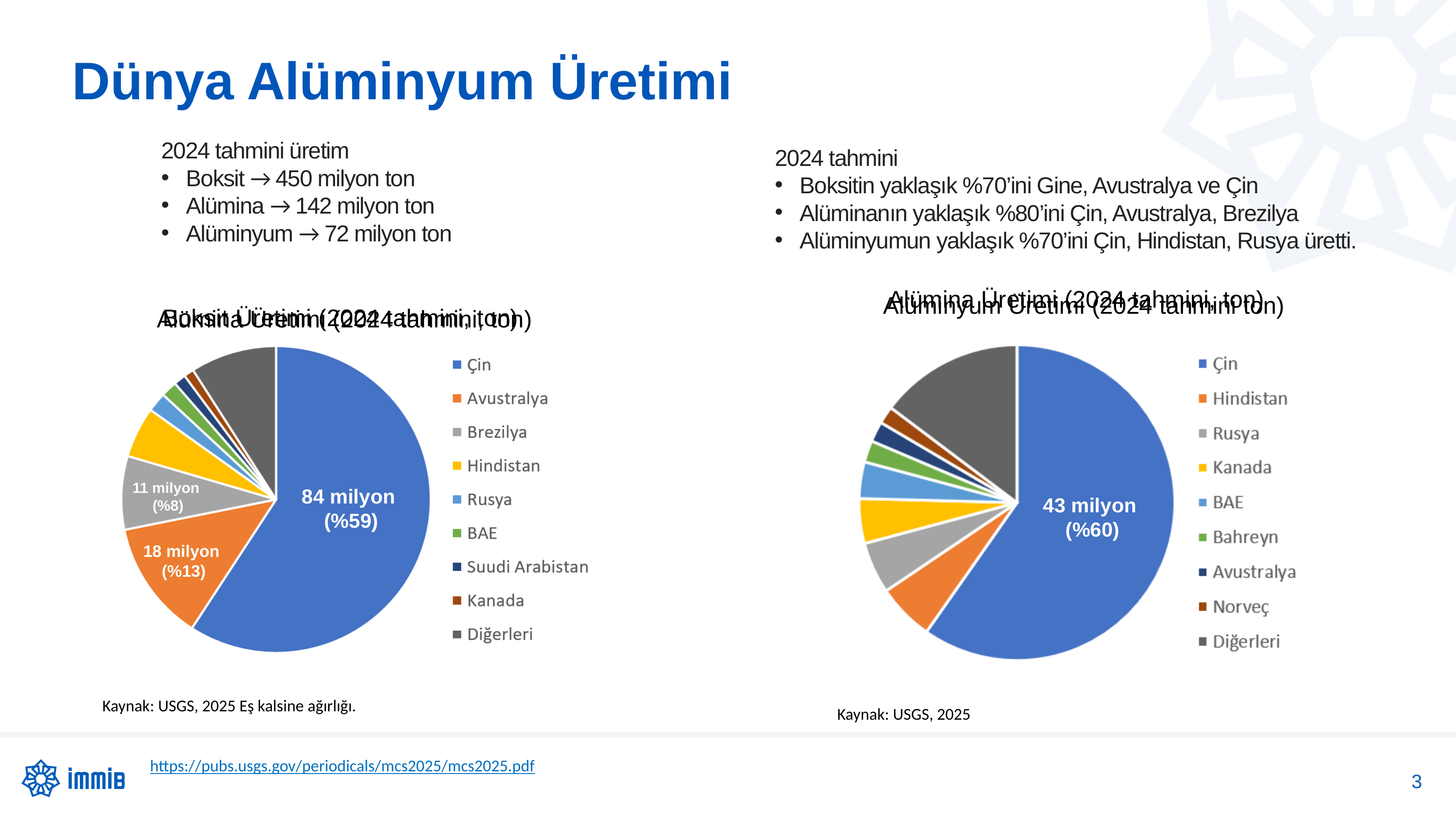
In the right pie chart, which legend entry is shown in orange? Hindistan In the left pie chart, what value is labelled for Çin? 84 milyon In the left pie chart, what share of the pie does Çin hold? %59 In the right pie chart, which is larger: the slice for Hindistan or the slice for Norveç? Hindistan How many categories does the legend of the left pie chart list? 9 What kind of chart is the left chart on the slide? pie chart In the right pie chart, what share of the pie does Çin hold? %60 In the left pie chart, what share of the pie does Brezilya hold? %8 In the left pie chart, what is the difference between the labelled values for Çin and Avustralya? 66 milyon In the left pie chart, what value is labelled for Avustralya? 18 milyon In the right pie chart, what value is labelled for Çin? 43 milyon In the left pie chart, which country has the largest slice? Çin